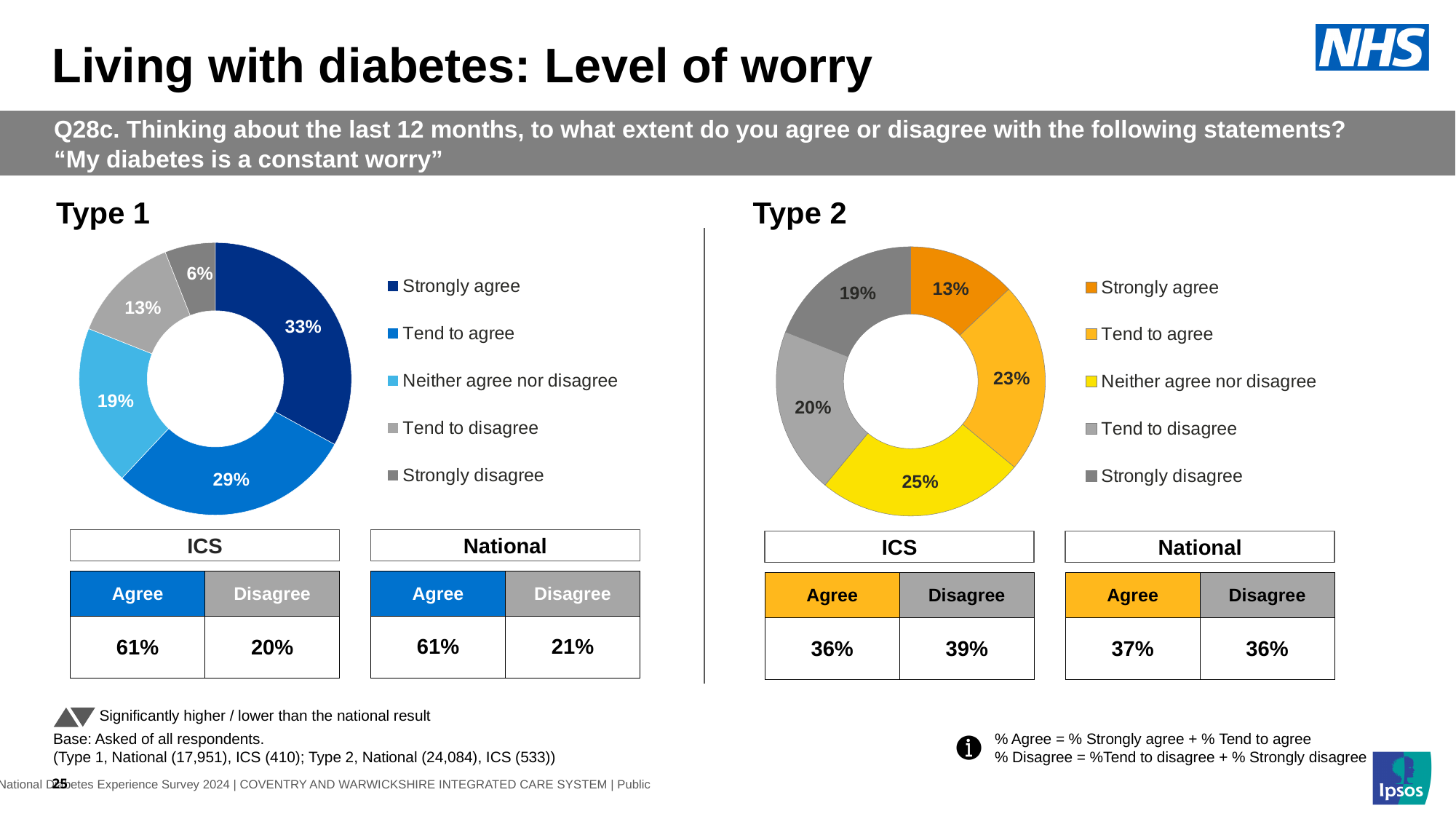
In the Type 2 chart, which is larger: Tend to agree or Tend to disagree? Tend to agree In the Type 2 chart, what percentage of respondents said they neither agree nor disagree? 25% In the Type 1 chart, what percentage of respondents said they strongly agree? 33% In the Type 1 chart, what is the difference in percentage points between Strongly agree and Tend to agree? 4 percentage points In the Type 2 chart, what percentage of respondents said they strongly disagree? 19% In the Type 2 chart, which response category has the largest share? Neither agree nor disagree In the Type 1 chart, which response category has the largest share? Strongly agree What type of chart is used to show the Type 1 results? Doughnut (pie) chart In the Type 1 chart, which response category has the smallest share? Strongly disagree In the Type 2 chart, which response category has the smallest share? Strongly agree In the Type 1 chart, what percentage of respondents said they tend to disagree? 13% How many response categories does the legend of the Type 2 chart list? 5